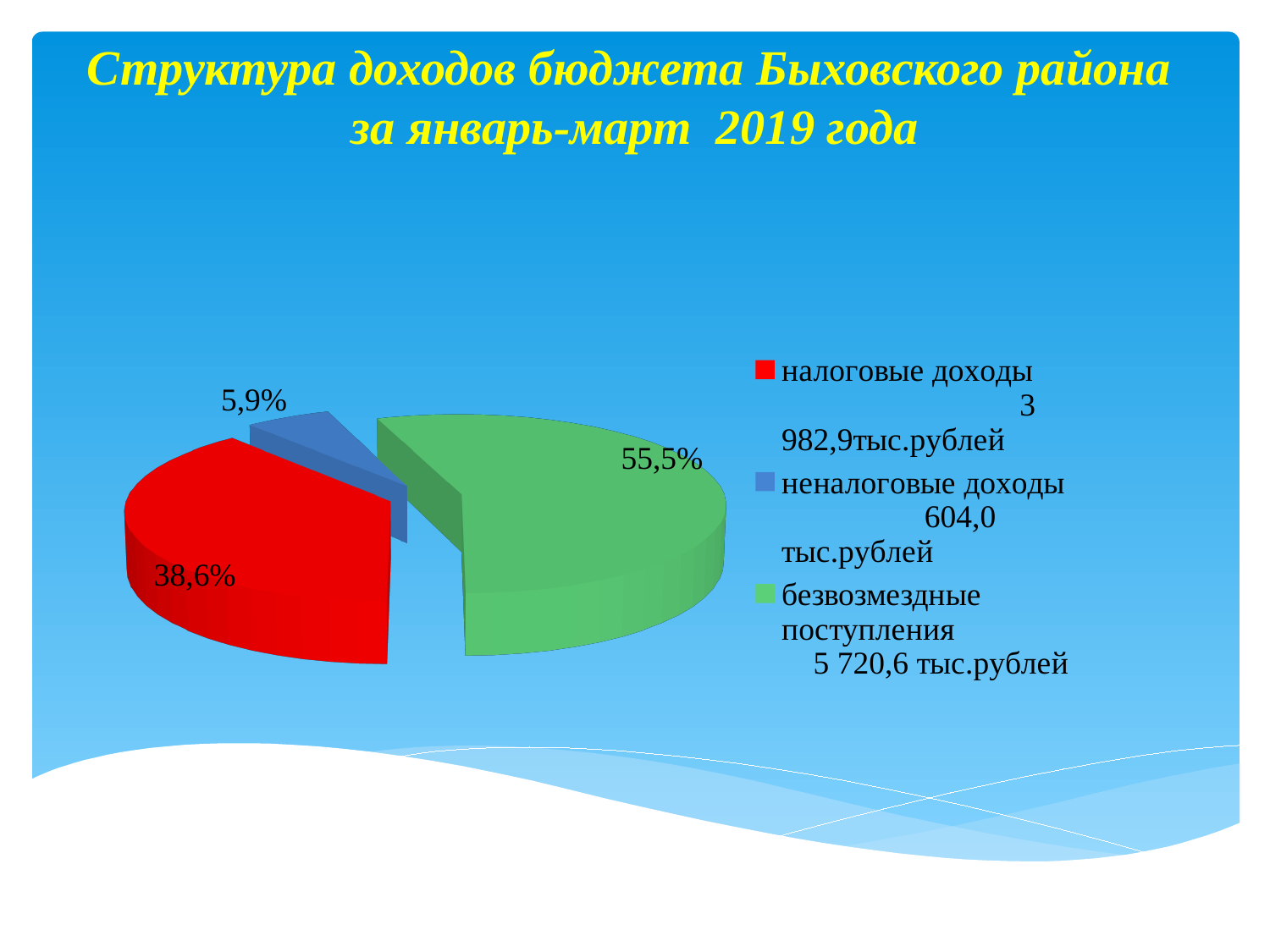
What share of the pie does налоговые доходы have? 38,6% What share of the pie does безвозмездные поступления have? 55,5% Which slice is larger: налоговые доходы or неналоговые доходы? налоговые доходы Which category has the smallest slice of the pie? неналоговые доходы What is the difference in percentage points between the безвозмездные поступления slice and the налоговые доходы slice? 16,9 What colour is the slice for неналоговые доходы? blue What amount in тыс.рублей does the legend give for безвозмездные поступления? 5 720,6 тыс.рублей Which category has the largest slice of the pie? безвозмездные поступления How many slices does the pie chart have? 3 What share of the pie does неналоговые доходы have? 5,9% How many entries does the legend list? 3 What kind of chart is shown on the slide? pie chart